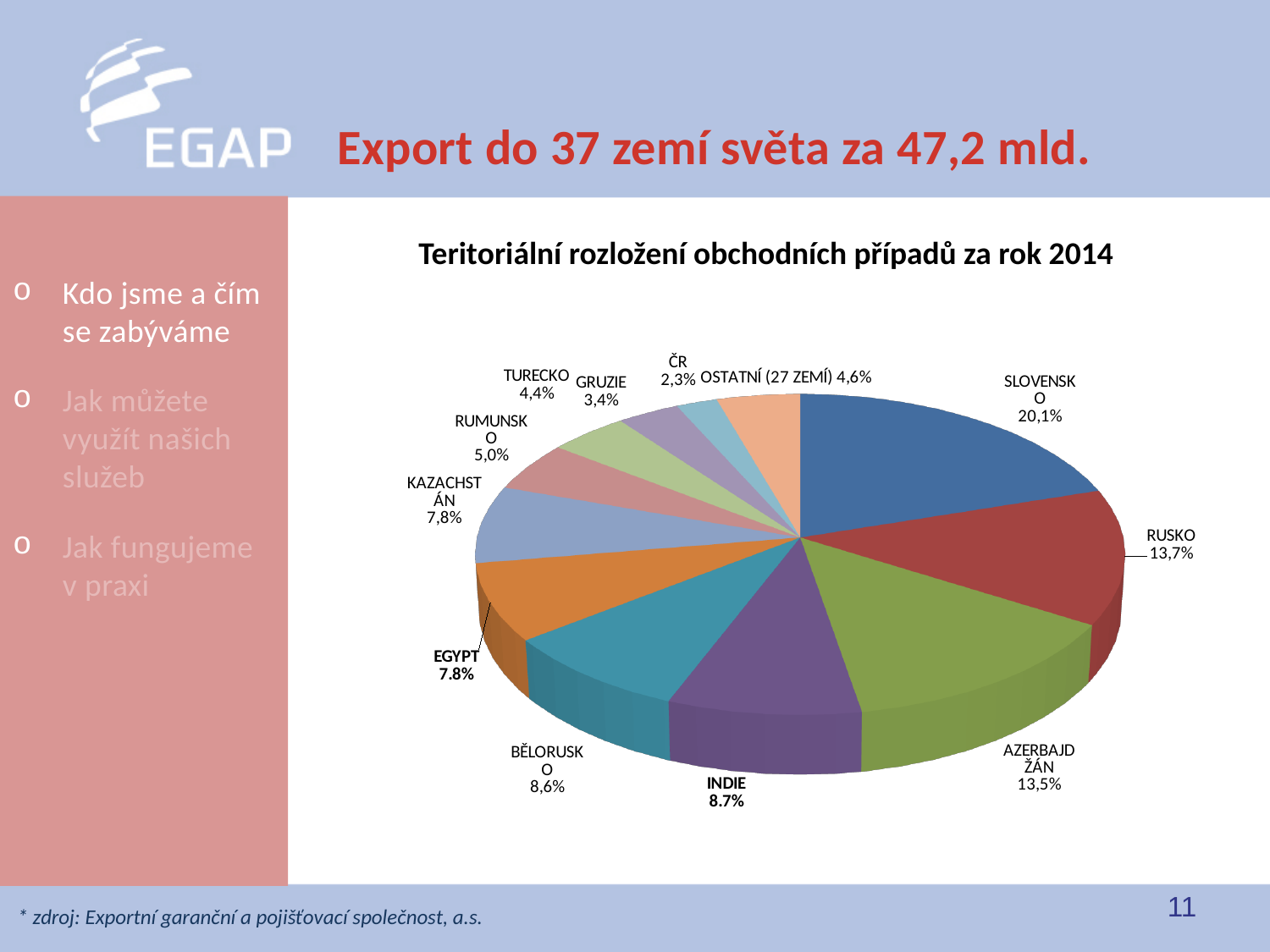
What share of the pie does BĚLORUSKO have? 8,6% What is the difference between the shares of SLOVENSKO and RUSKO? 6,4% How many slices does the pie chart have? 12 What is the title of the chart? Teritoriální rozložení obchodních případů za rok 2014 Which slice of the pie is the smallest? ČR Which has a larger share, RUMUNSKO or TURECKO? RUMUNSKO What share of the pie does AZERBAJDŽÁN have? 13,5% What kind of chart is shown on the slide? pie chart What share of the pie does OSTATNÍ (27 ZEMÍ) have? 4,6% What share of the pie does SLOVENSKO have? 20,1% Which country has the largest slice of the pie? SLOVENSKO What share of the pie does RUSKO have? 13,7%